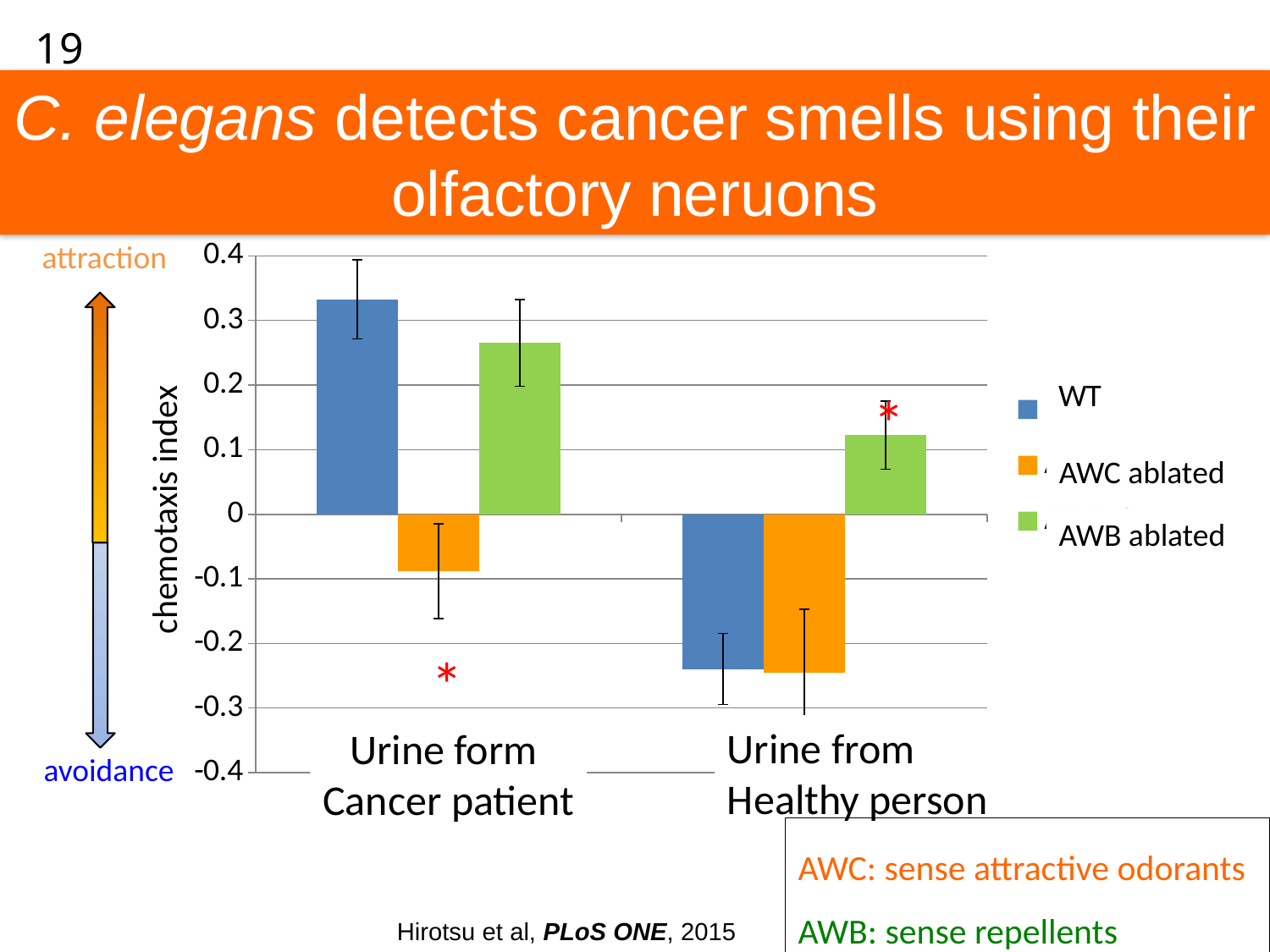
Is the WT value for urine from a cancer patient greater or less than 0.2? greater Is the AWC ablated value for urine from a cancer patient greater or less than 0? less Which series has the highest chemotaxis index for urine from a healthy person? AWB ablated What kind of chart is shown on the slide? bar chart Which series has the lowest chemotaxis index for urine from a cancer patient? AWC ablated How many series does the legend list? 3 What is the label of the y axis? chemotaxis index Which series has the highest chemotaxis index for urine from a cancer patient? WT For urine from a cancer patient, which is larger: the WT value or the AWB ablated value? WT Is the WT value for urine from a healthy person greater or less than -0.2? less How many categories are shown on the x axis? 2 For the AWB ablated series, which category has the larger value: urine from a cancer patient or urine from a healthy person? Urine from Cancer patient